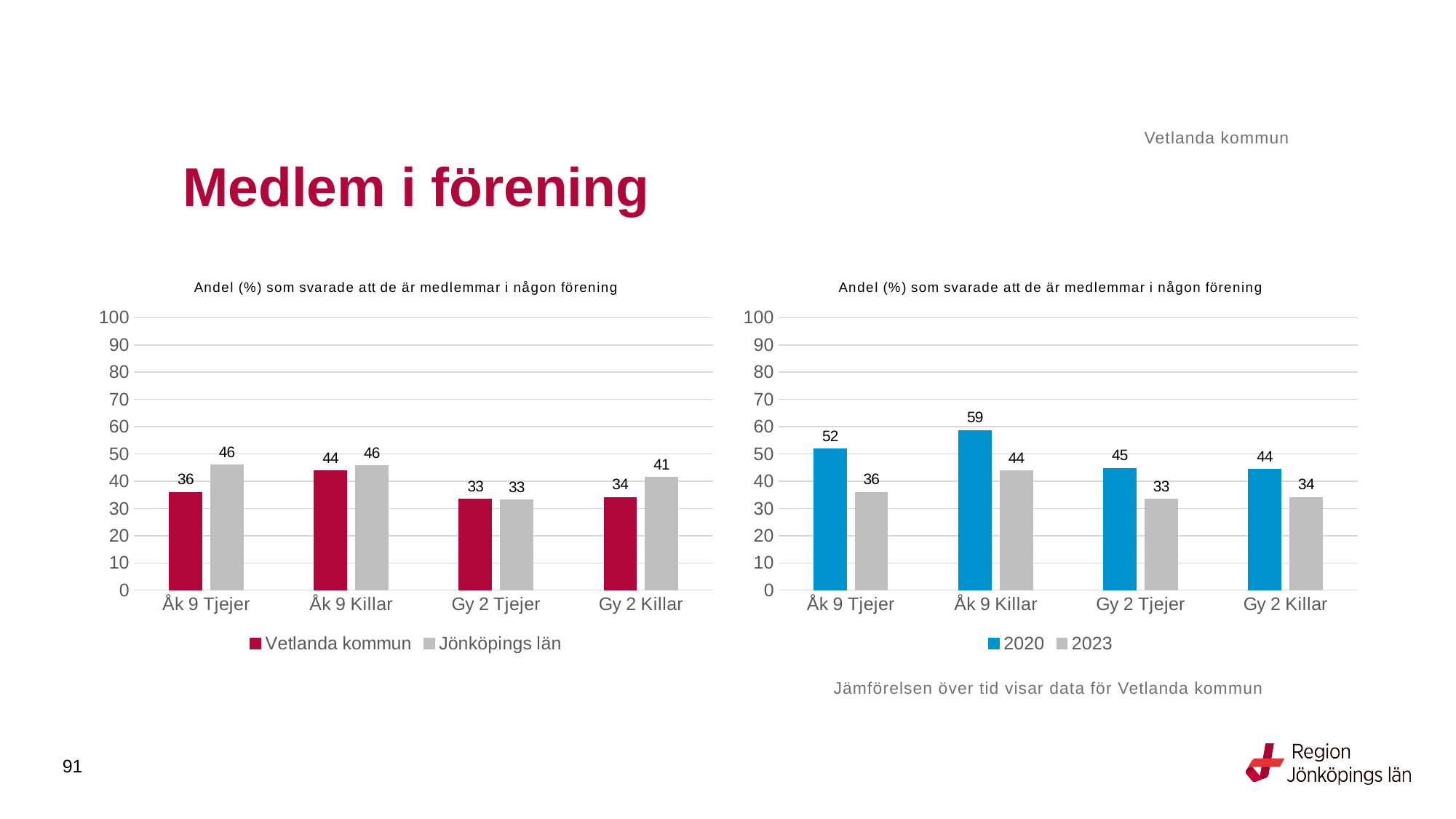
In the right chart, which category has the highest value for 2020? Åk 9 Killar In the left chart, what is the value for Vetlanda kommun for Åk 9 Tjejer? 36 In the left chart, what is the difference between Jönköpings län and Vetlanda kommun for Åk 9 Tjejer? 10 What kind of chart is the right chart? Bar chart In the left chart, which category has the lowest value for Vetlanda kommun? Gy 2 Tjejer In the right chart, what is the value for 2023 for Gy 2 Tjejer? 33 In the left chart, which is larger for Gy 2 Killar: Vetlanda kommun or Jönköpings län? Jönköpings län In the right chart, what is the difference between the 2020 and 2023 values for Åk 9 Tjejer? 16 How many series does the legend of the left chart list? 2 In the left chart, what is the value for Jönköpings län for Gy 2 Killar? 41 How many categories are shown on the x axis of the right chart? 4 In the right chart, what is the value for 2020 for Åk 9 Killar? 59